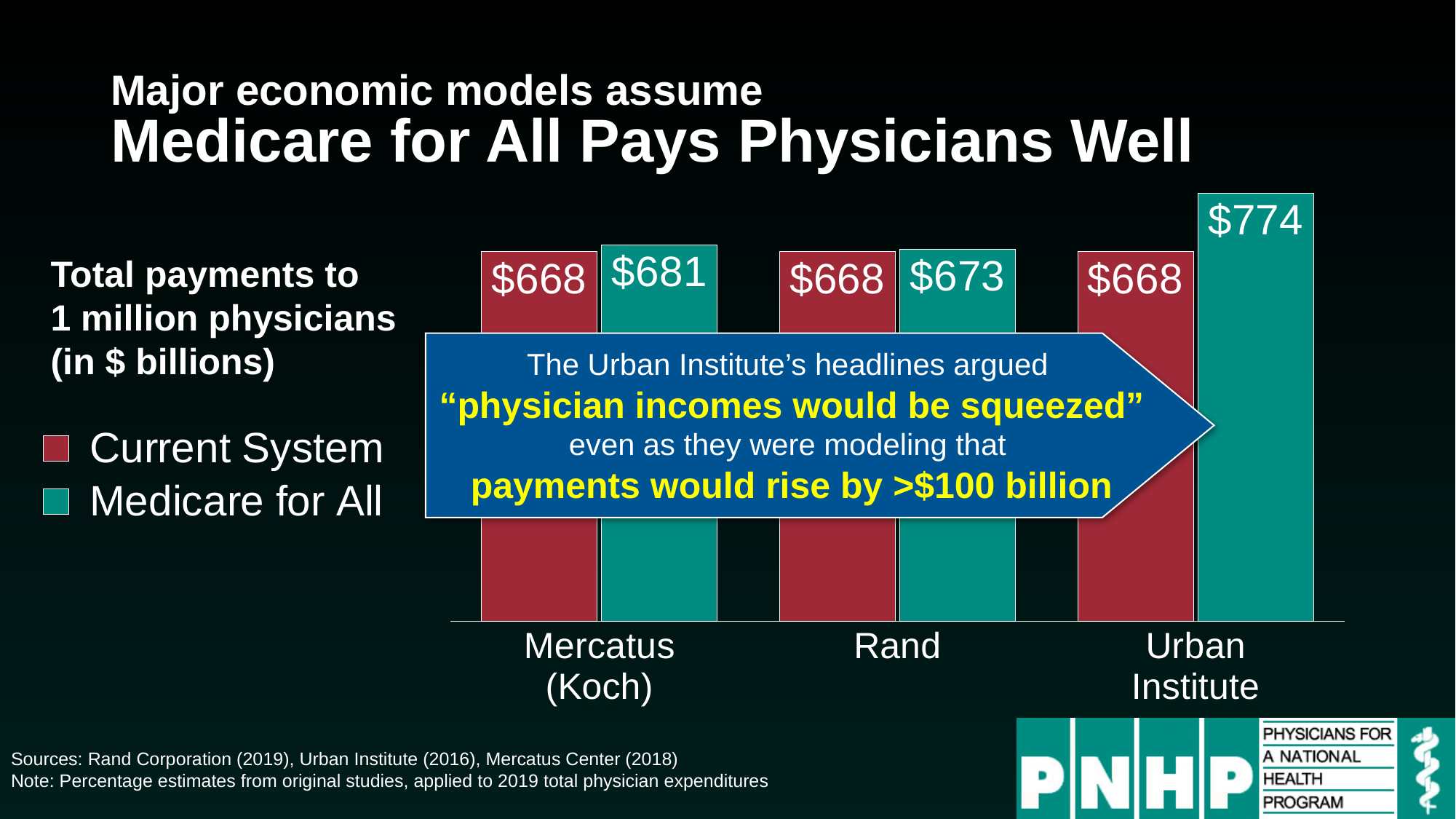
What kind of chart is shown on the slide? Bar chart Which category has the lowest Medicare for All value? Rand What is the difference between the Medicare for All values for Mercatus (Koch) and Rand? $8 What is the Medicare for All value for Mercatus (Koch)? $681 What is the difference between the Medicare for All and Current System values for the Urban Institute? $106 Which category has the highest Medicare for All value? Urban Institute What is the Medicare for All value for the Urban Institute? $774 How many series does the legend list? 2 How many categories are shown on the x axis? 3 What is the Current System value for Rand? $668 Which is larger for Mercatus (Koch): the Current System value or the Medicare for All value? Medicare for All What is the Medicare for All value for Rand? $673